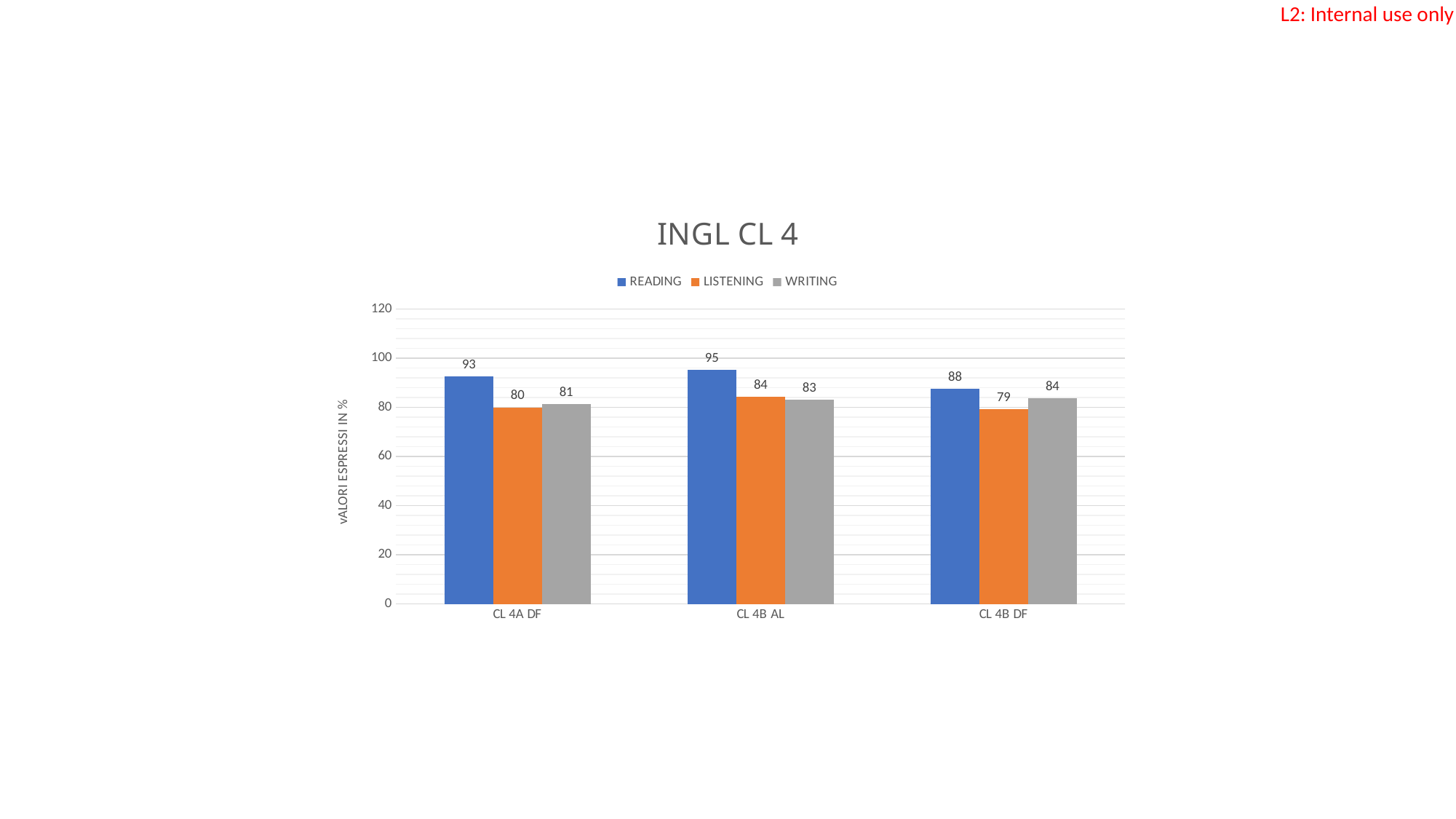
Is the READING value for CL 4B AL greater or less than 80? greater How many series does the legend list? 3 Which is larger for CL 4B DF, the READING value or the WRITING value? READING Which category has the lowest LISTENING value? CL 4B DF What is the difference between the READING and LISTENING values for CL 4A DF? 13 What is the READING value for CL 4B AL? 95 Which category has the highest READING value? CL 4B AL What is the title of the chart? INGL CL 4 How many categories are shown on the x axis? 3 What is the LISTENING value for CL 4B DF? 79 What is the WRITING value for CL 4A DF? 81 What kind of chart is shown on the slide? bar chart